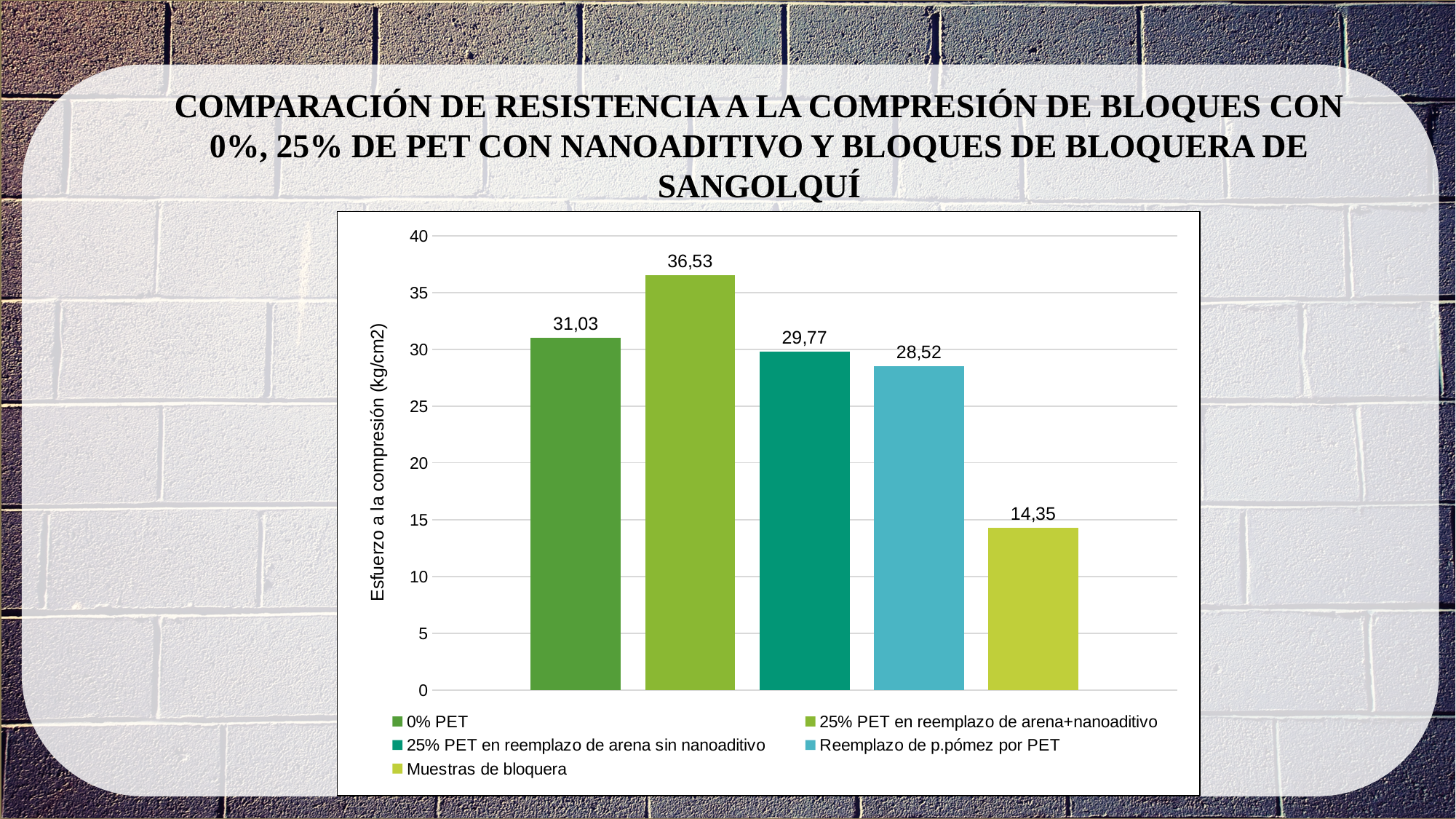
What is the difference between the values for 25% PET en reemplazo de arena+nanoaditivo and Muestras de bloquera? 22,18 Which series has the highest compressive strength? 25% PET en reemplazo de arena+nanoaditivo What is the value shown for Reemplazo de p.pómez por PET? 28,52 Which is larger, the value for 0% PET or the value for 25% PET en reemplazo de arena sin nanoaditivo? 0% PET What kind of chart is shown on the slide? Bar chart What is the value shown for 25% PET en reemplazo de arena+nanoaditivo? 36,53 What is the difference between the values for 25% PET en reemplazo de arena+nanoaditivo and 0% PET? 5,50 What is the compressive strength value for 0% PET? 31,03 How many series does the legend list? 5 What is the value shown for Muestras de bloquera? 14,35 Which series has the lowest compressive strength? Muestras de bloquera What is the label of the vertical axis? Esfuerzo a la compresión (kg/cm2)